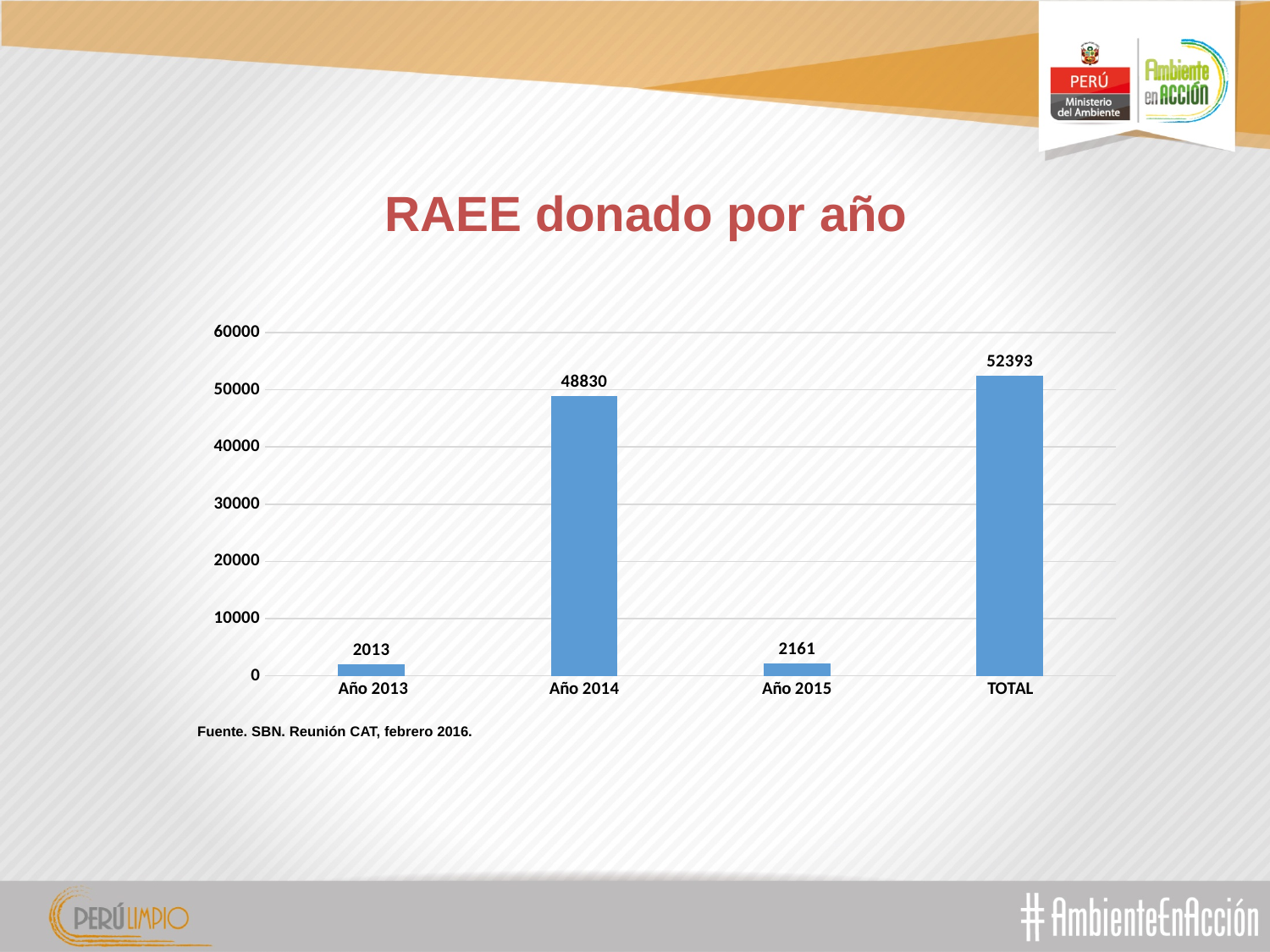
What is the difference between the values for Año 2015 and Año 2013? 148 What is the value for Año 2015? 2161 What is the value for Año 2013? 2013 What is the difference between the values for Año 2014 and Año 2015? 46669 Which category has the lowest value? Año 2013 What type of chart is shown on the slide? Bar chart Which is larger, the value for Año 2014 or the value for Año 2015? Año 2014 Which category has the highest value? TOTAL How many bars are shown in the chart? 4 What is the value shown for TOTAL? 52393 Is the value for Año 2014 greater or less than 40000? greater What is the value for Año 2014? 48830